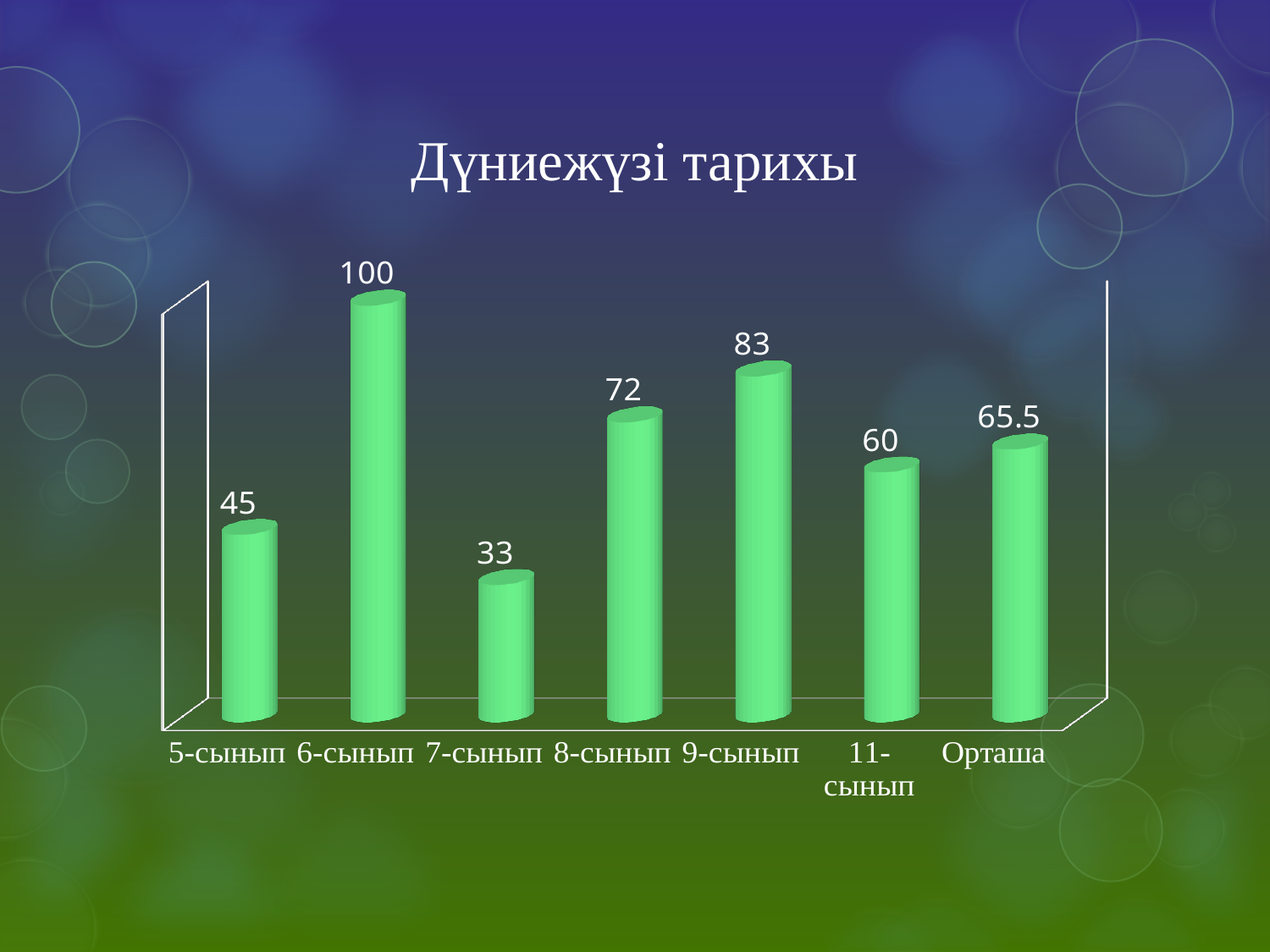
What is the difference between the values for 9-сынып and 8-сынып? 11 Which category has the lowest value? 7-сынып Which category has the highest value? 6-сынып What is the value for 5-сынып? 45 What is the value for 6-сынып? 100 How many categories are shown on the x axis? 7 What is the difference between the values for 6-сынып and 7-сынып? 67 What colour are the bars in the chart? green Which is larger, the value for 11-сынып or the value for 5-сынып? 11-сынып What is the title of the chart? Дүниежүзі тарихы What kind of chart is shown on the slide? bar chart What is the value for Орташа? 65.5